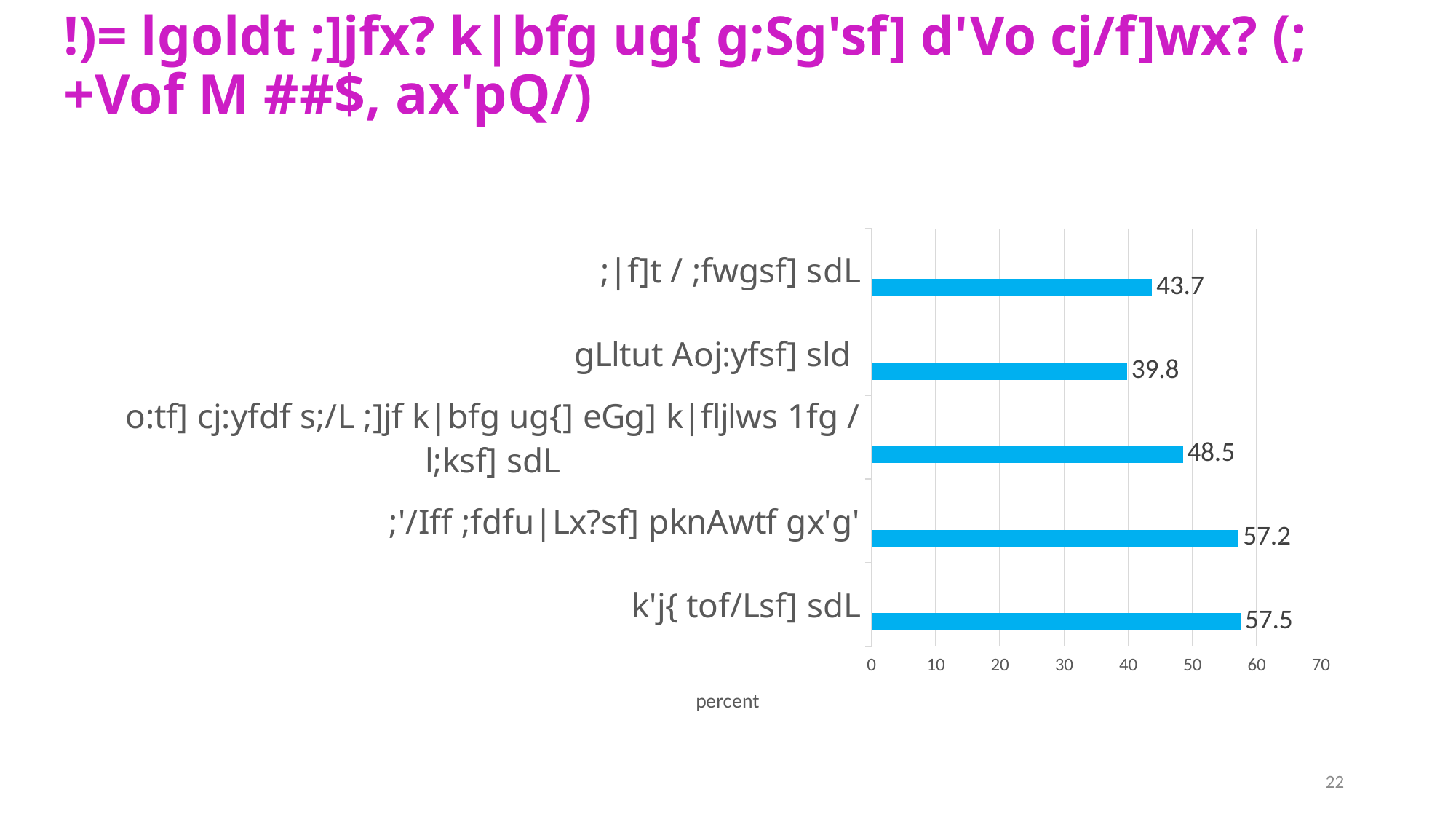
What kind of chart is shown on the slide? bar chart What is the value for ";'/Iff ;fdfu|Lx?sf] pknAwtf gx'g'"? 57.2 What is the value for ";|f]t / ;fwgsf] sdL"? 43.7 What is the value for "gLltut Aoj:yfsf] sld"? 39.8 What is the difference between the values for "k'j{ tof/Lsf] sdL" and "gLltut Aoj:yfsf] sld"? 17.7 Which is larger, the value for ";|f]t / ;fwgsf] sdL" or the value for "gLltut Aoj:yfsf] sld"? ;|f]t / ;fwgsf] sdL Is the value for ";'/Iff ;fdfu|Lx?sf] pknAwtf gx'g'" greater or less than 50? greater What is the label on the horizontal axis of the chart? percent Which category has the lowest value? gLltut Aoj:yfsf] sld Which category has the highest value? k'j{ tof/Lsf] sdL What is the value for "k'j{ tof/Lsf] sdL"? 57.5 How many categories are shown in the chart? 5